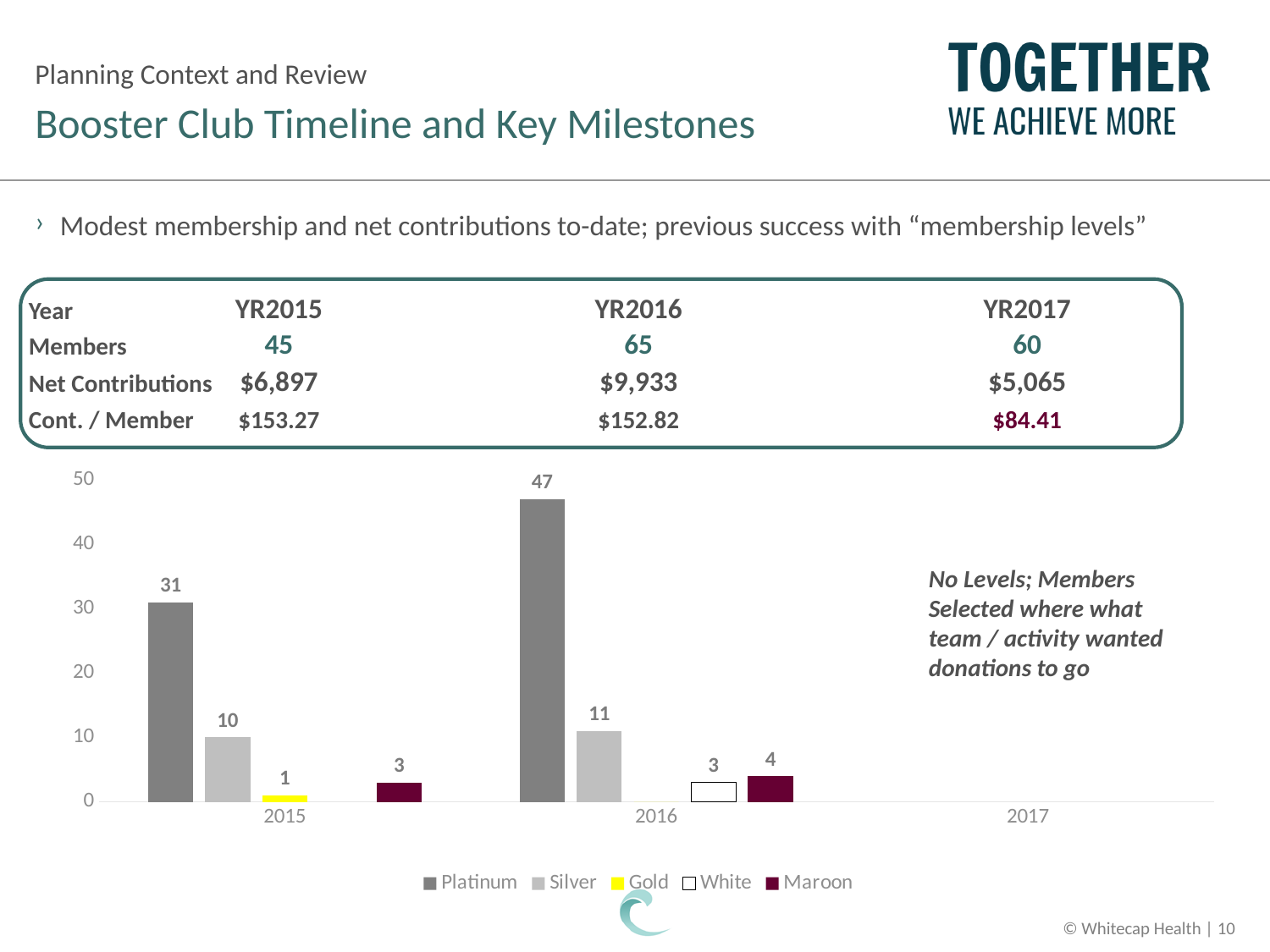
Which is larger, the Maroon bar for 2016 or the White bar for 2016? Maroon How many series does the legend list? 5 What is the value of the Gold bar for 2015? 1 What is the value of the Platinum bar for 2015? 31 Which series has the highest value in 2016? Platinum What kind of chart is shown on the slide? Bar chart What is the value of the Maroon bar for 2015? 3 Which year on the x axis has no bars plotted? 2017 What is the value of the Platinum bar for 2016? 47 Which series has the lowest value in 2015? Gold What is the difference between the Platinum values for 2016 and 2015? 16 What is the value of the Silver bar for 2016? 11